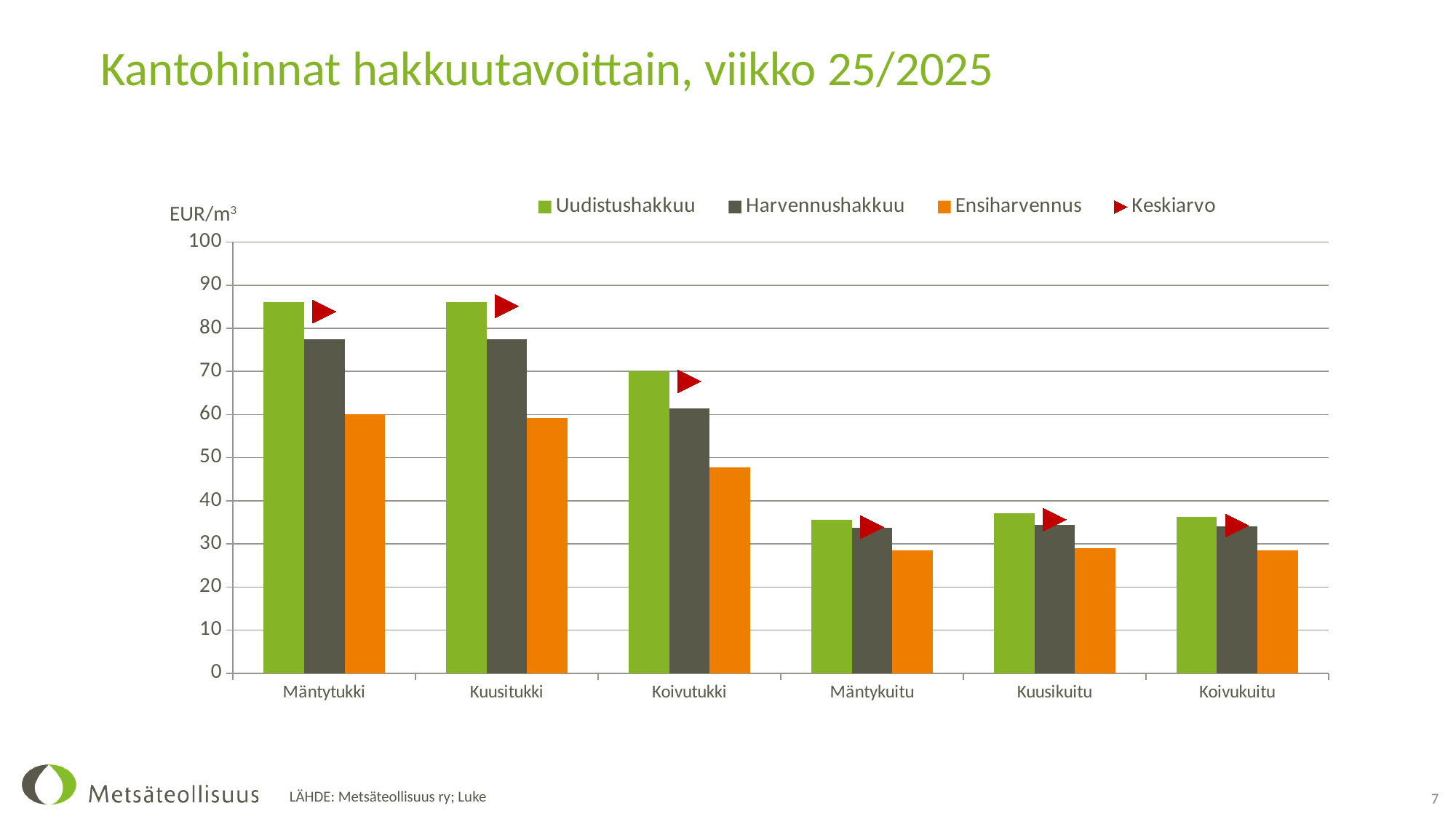
For Mäntytukki, which series has the lowest bar? Ensiharvennus Is the Uudistushakkuu value for Mäntytukki greater or less than 80? greater Is the Harvennushakkuu value for Kuusitukki greater or less than 80? less Is the Ensiharvennus value for Mäntykuitu greater or less than 30? less How many categories are shown on the x axis? 6 What unit is shown on the vertical axis? EUR/m³ How many series does the legend list? 4 For Koivutukki, which series has the highest bar? Uudistushakkuu What kind of chart is shown on the slide? bar chart Which is larger: the Uudistushakkuu value for Koivutukki or for Mäntykuitu? Koivutukki